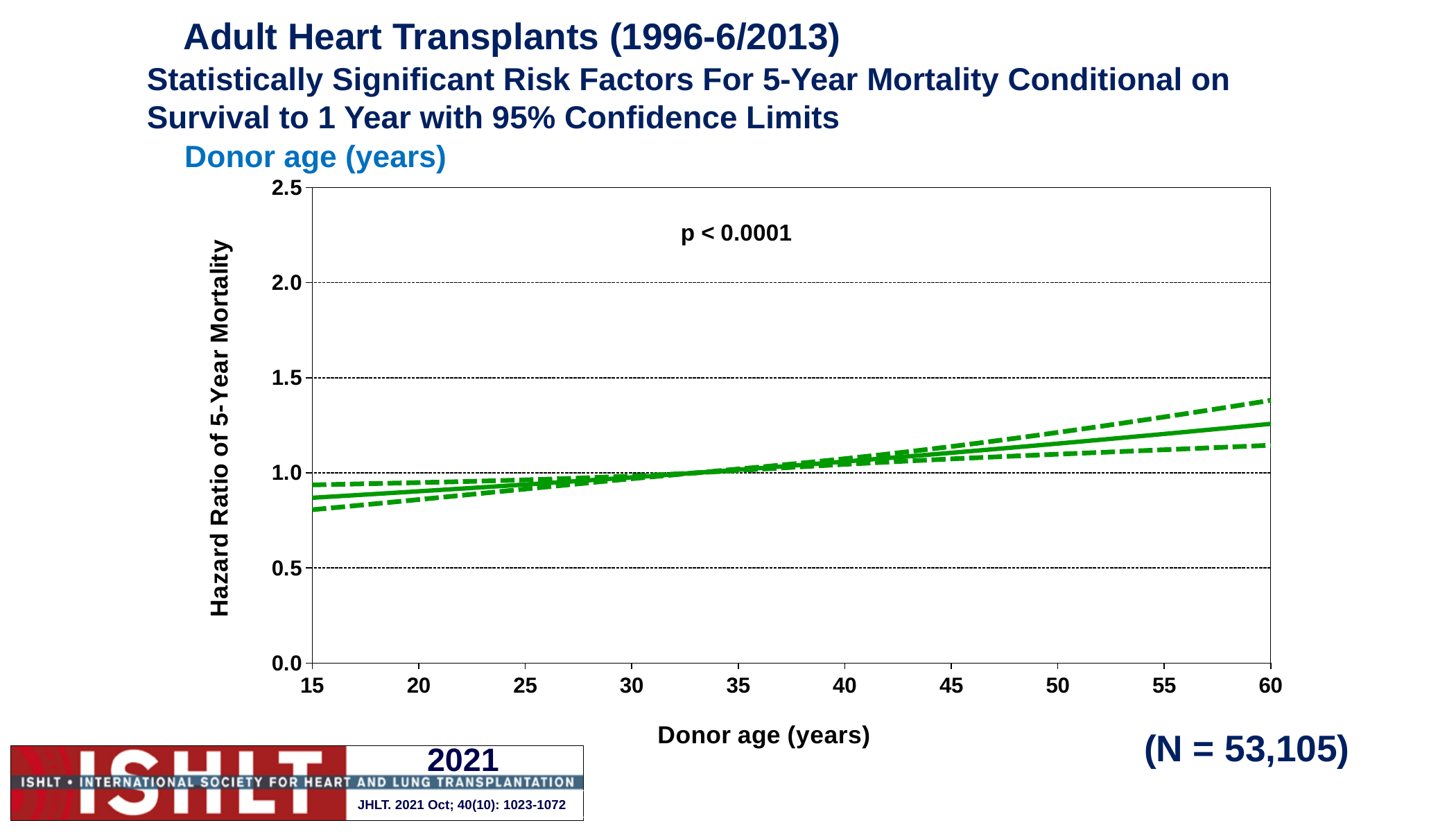
What p-value is printed on the chart? p < 0.0001 What sample size (N) is shown on the slide? N = 53,105 Does the hazard ratio of 5-year mortality rise or fall as donor age increases from 15 to 60 years? rise Is the hazard ratio for a donor age of 15 years greater or less than 0.5? greater Is the hazard ratio for a donor age of 60 years greater or less than 1.0? greater Which donor age has the larger hazard ratio, 15 years or 60 years? 60 years How many tick labels are shown on the x axis (donor age)? 10 Which donor age has the larger hazard ratio, 20 years or 50 years? 50 years What kind of chart is shown on the slide? line chart Is the hazard ratio for a donor age of 15 years greater or less than 1.0? less